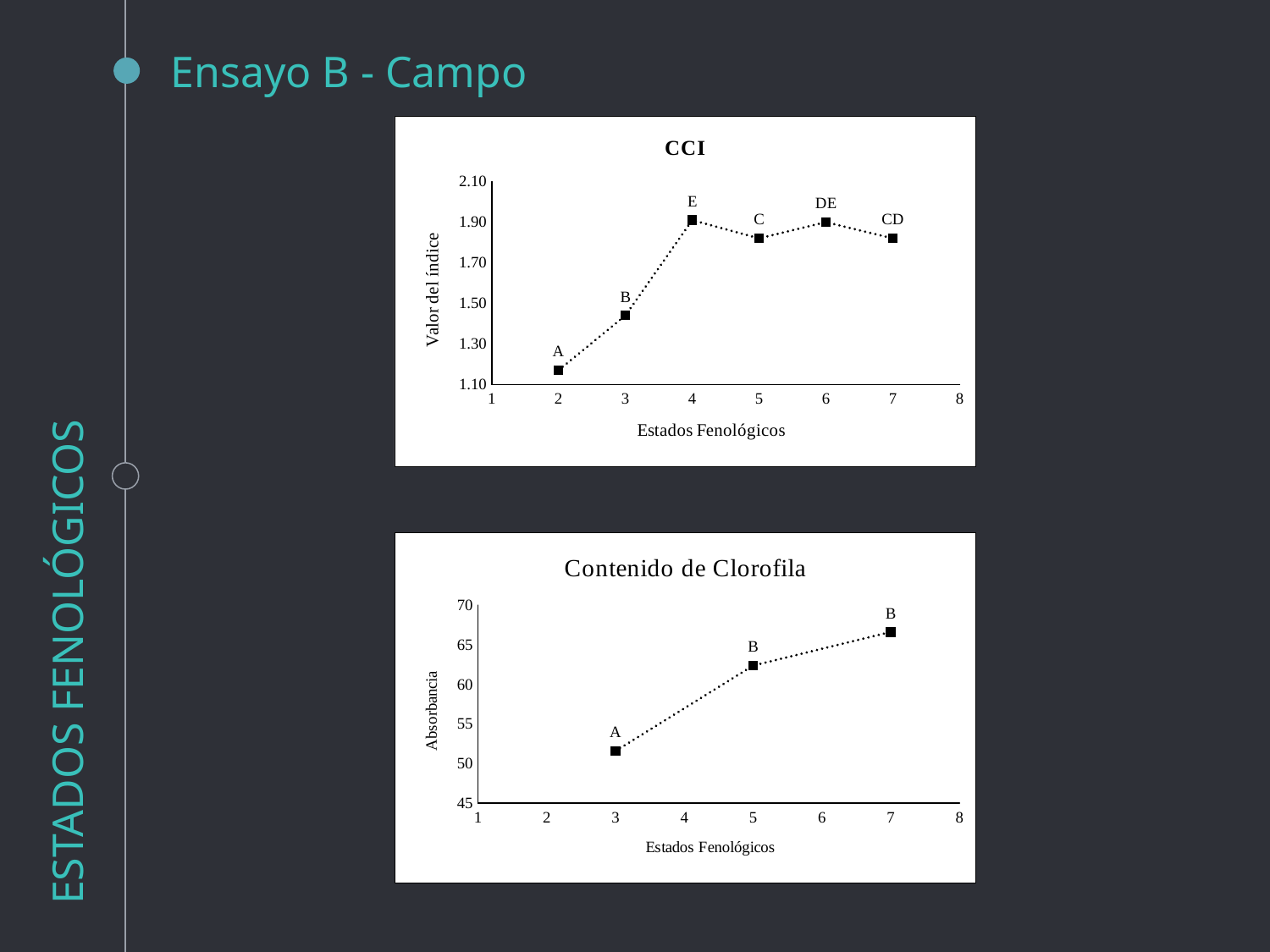
In the Contenido de Clorofila chart, do the values rise or fall as the phenological stage increases? rise In the CCI chart, is the value at phenological stage 3 greater or less than 1.50? less In the CCI chart, how many data points are plotted? 6 In the CCI chart, which is larger, the value at stage 3 or the value at stage 5? stage 5 What kind of chart is the CCI chart at the top of the slide? line chart In the CCI chart, is the value at phenological stage 4 greater or less than 1.70? greater In the CCI chart, what letter labels the point at phenological stage 4? E In the Contenido de Clorofila chart, is the value at phenological stage 5 greater or less than 60? greater In the Contenido de Clorofila chart, which phenological stage (x value) has the highest absorbance? 7 In the CCI chart, which phenological stage (x value) has the lowest index value? 2 In the Contenido de Clorofila chart, how many data points are plotted? 3